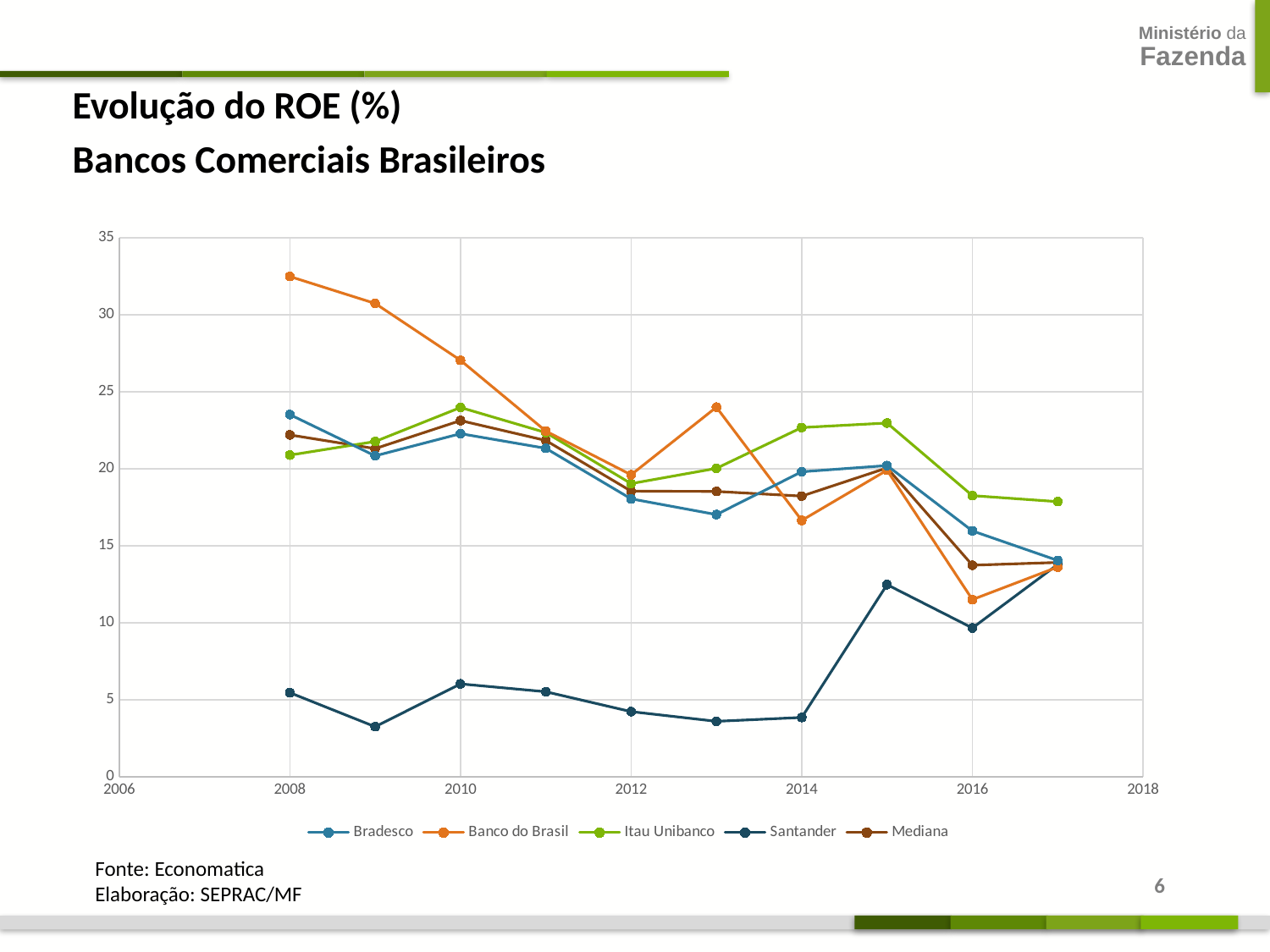
Is the value for Banco do Brasil in 2008 greater or less than 30? greater What kind of chart is shown on the slide? line chart Which is larger in 2010, the value for Banco do Brasil or the value for Santander? Banco do Brasil Is the value for Santander in 2013 greater or less than 5? less How many series does the legend list? 5 What is the title of the chart? Evolução do ROE (%) Bancos Comerciais Brasileiros Which series has the highest ROE in 2008? Banco do Brasil Does the Banco do Brasil line rise or fall from 2008 to 2010? fall Which series has the highest ROE in 2017? Itau Unibanco Is the value for Banco do Brasil in 2016 greater or less than 15? less Which series has the lowest ROE in 2008? Santander How many yearly data points does each series have? 10